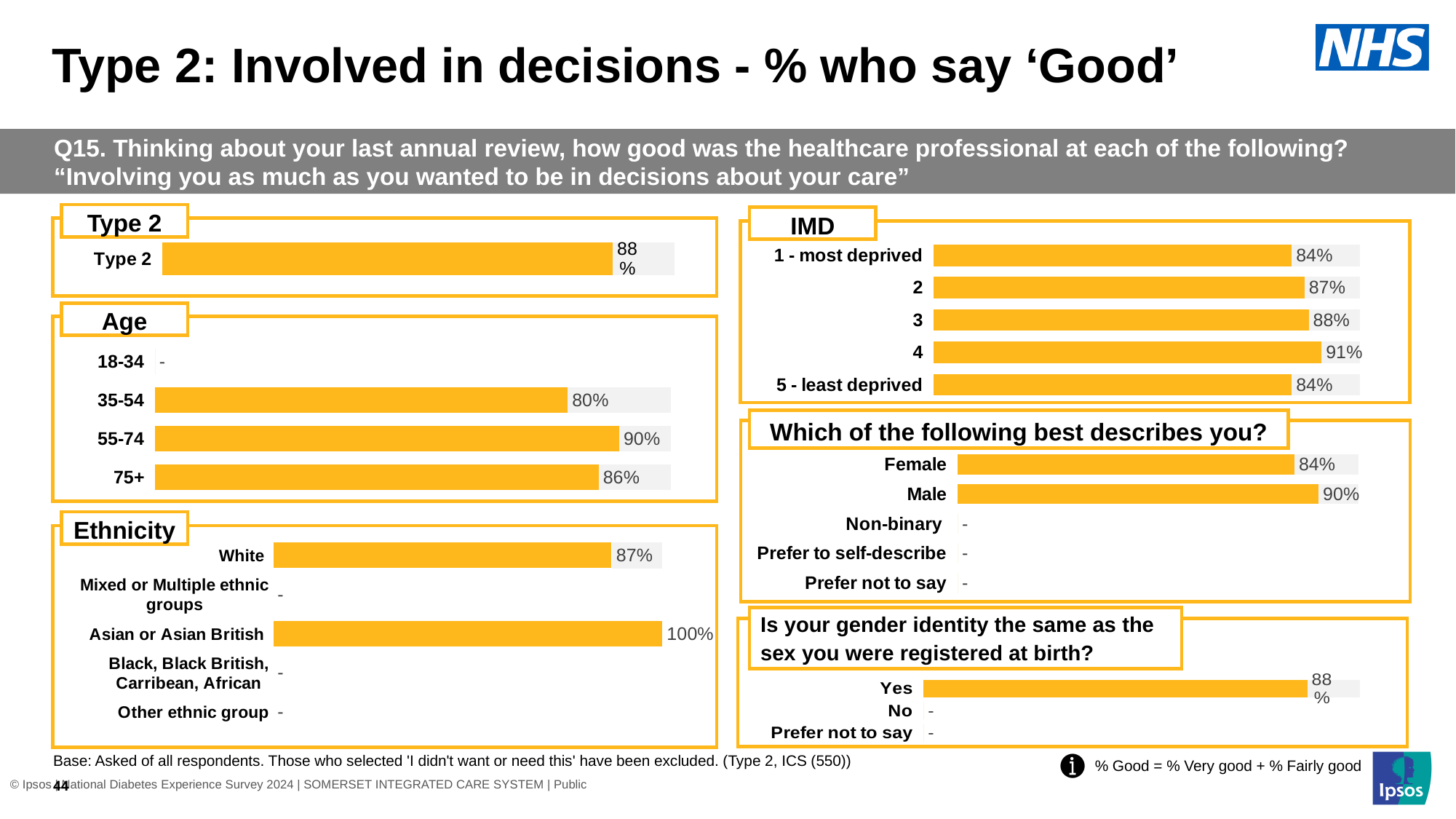
In the IMD chart, what is the value for 2? 87% In the 'Which of the following best describes you?' chart, what is the difference between the values for Male and Female? 6% In the 'Is your gender identity the same as the sex you were registered at birth?' chart, what is the value for Yes? 88% In the Age chart, which age group has the lowest value among those with a bar shown? 35-54 In the IMD chart, which category has the highest value? 4 In the Age chart, what is the value for 55-74? 90% In the Age chart, what is the difference between the values for 55-74 and 35-54? 10% In the Ethnicity chart, which category has the highest value? Asian or Asian British In the Ethnicity chart, what is the value for Asian or Asian British? 100% In the IMD chart, how many categories are listed? 5 In the Type 2 chart, what is the value for Type 2? 88% In the 'Which of the following best describes you?' chart, which is larger, Female or Male? Male